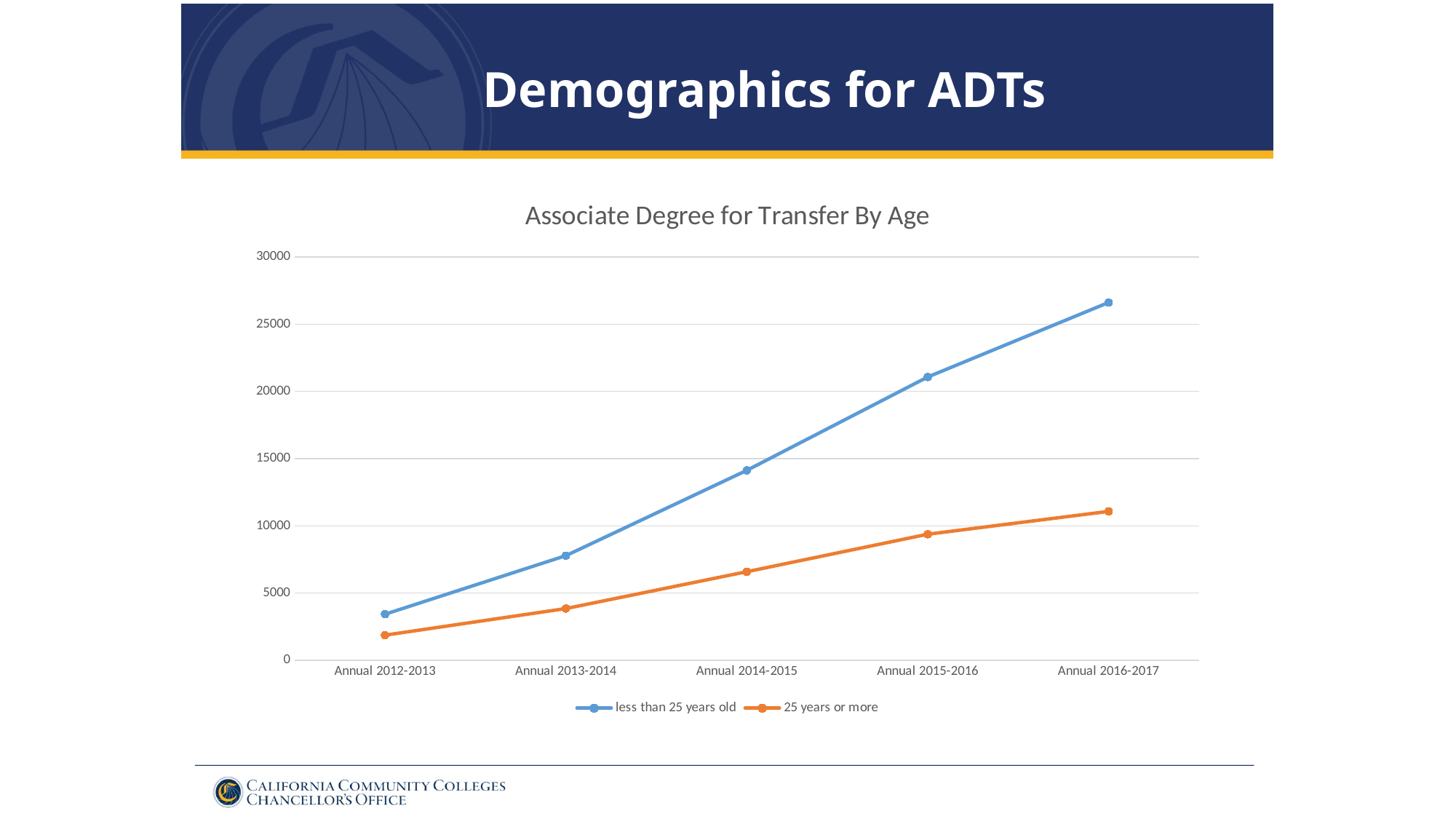
In which annual period is the value for '25 years or more' lowest? Annual 2012-2013 In which annual period is the value for 'less than 25 years old' highest? Annual 2016-2017 What is the title of the chart? Associate Degree for Transfer By Age How many annual periods are shown on the x axis? 5 How many series does the legend list? 2 In Annual 2015-2016, which series has the larger value: 'less than 25 years old' or '25 years or more'? less than 25 years old Is the value for '25 years or more' in Annual 2015-2016 greater or less than 10000? less What kind of chart is shown on the slide? line chart Is the value for 'less than 25 years old' in Annual 2016-2017 greater or less than 25000? greater Do the values for '25 years or more' rise or fall across the years shown? rise Which series is drawn in orange? 25 years or more Do the values for 'less than 25 years old' rise or fall from Annual 2012-2013 to Annual 2016-2017? rise